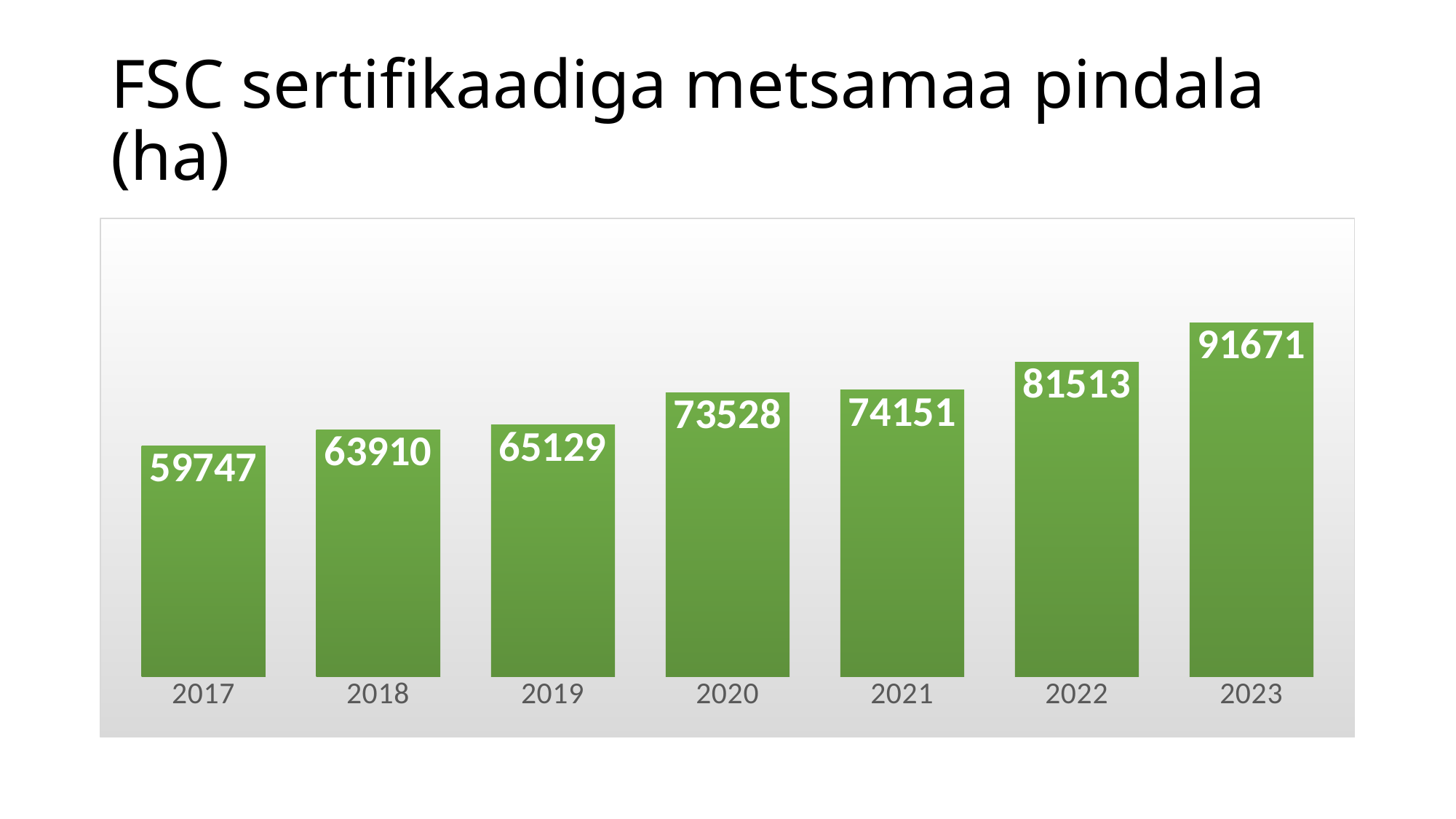
What is the value for 2020? 73528 What is the value for 2017? 59747 What is the difference between the values for 2023 and 2022? 10158 What is the title of the chart on the slide? FSC sertifikaadiga metsamaa pindala (ha) What kind of chart is shown on the slide? bar chart Which year has the lowest value? 2017 Which year has the highest value? 2023 Which is larger, the value for 2019 or the value for 2021? 2021 How many years are shown on the chart? 7 What is the value for 2023? 91671 What is the difference between the values for 2018 and 2017? 4163 Do the values rise or fall from 2017 to 2023? rise